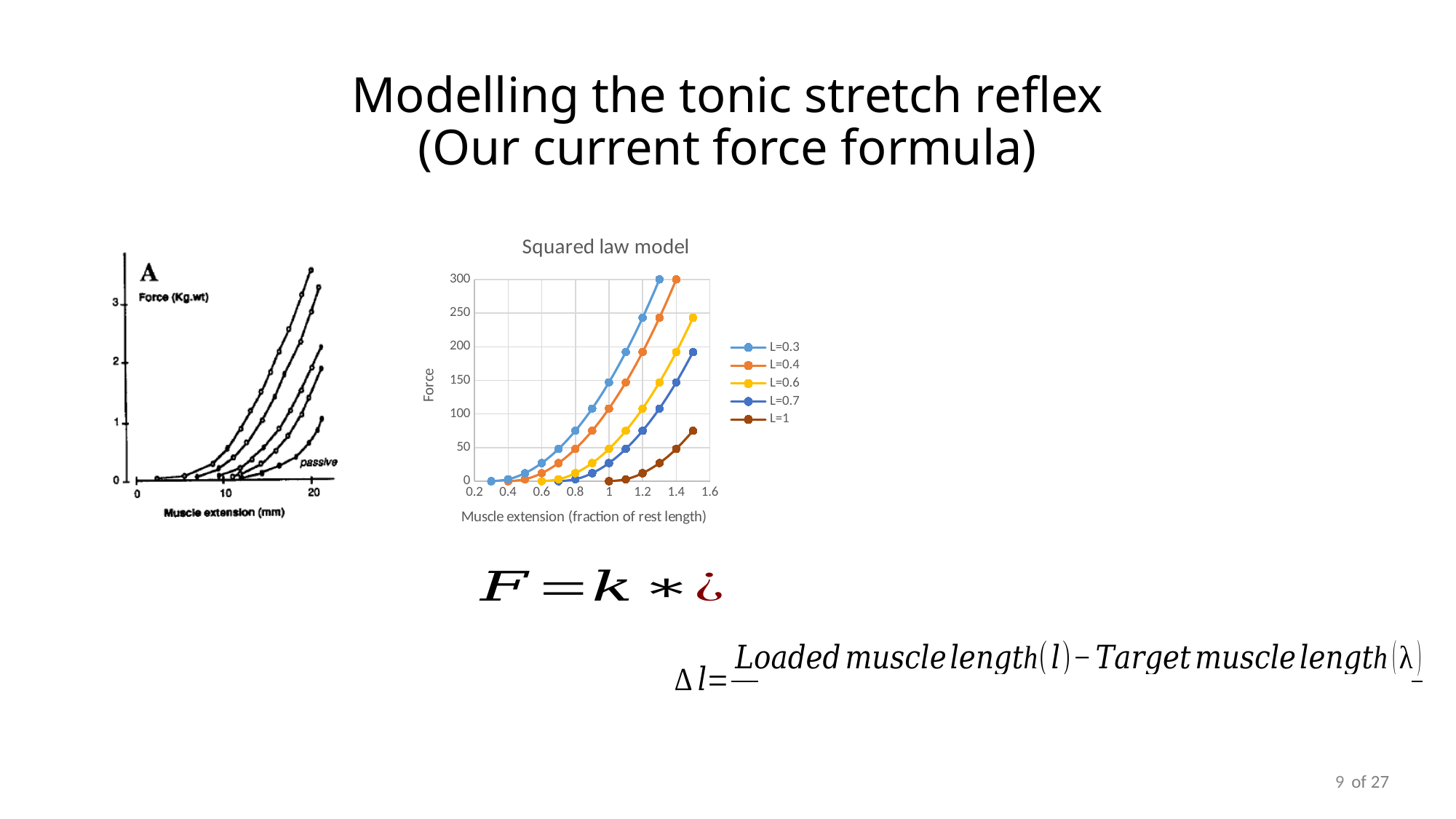
In the 'Squared law model' chart, is the Force value for the L=1 series at a muscle extension of 1.5 greater or less than 100? less In the 'Squared law model' chart, what is the Force value for the L=0.3 series at a muscle extension of 0.3? 0 What kind of chart is the 'Squared law model' chart? Line chart In the 'Squared law model' chart, at a muscle extension of 1.2, which series has the larger Force value: L=0.3 or L=1? L=0.3 In the 'Squared law model' chart, what is the Force value for the L=1 series at a muscle extension of 1? 0 In the 'Squared law model' chart, does the Force for the L=0.4 series rise or fall as muscle extension increases? Rise In the 'Squared law model' chart, what is the label of the x axis? Muscle extension (fraction of rest length) What is the title of the chart on the right of the slide? Squared law model In the chart on the left of the slide, what is the label of the x axis? Muscle extension (mm) In the 'Squared law model' chart, how many series does the legend list? 5 In the 'Squared law model' chart, is the Force value for the L=0.6 series at a muscle extension of 1.5 greater or less than 200? greater In the 'Squared law model' chart, is the Force value for the L=0.7 series at a muscle extension of 1.5 greater or less than 150? greater